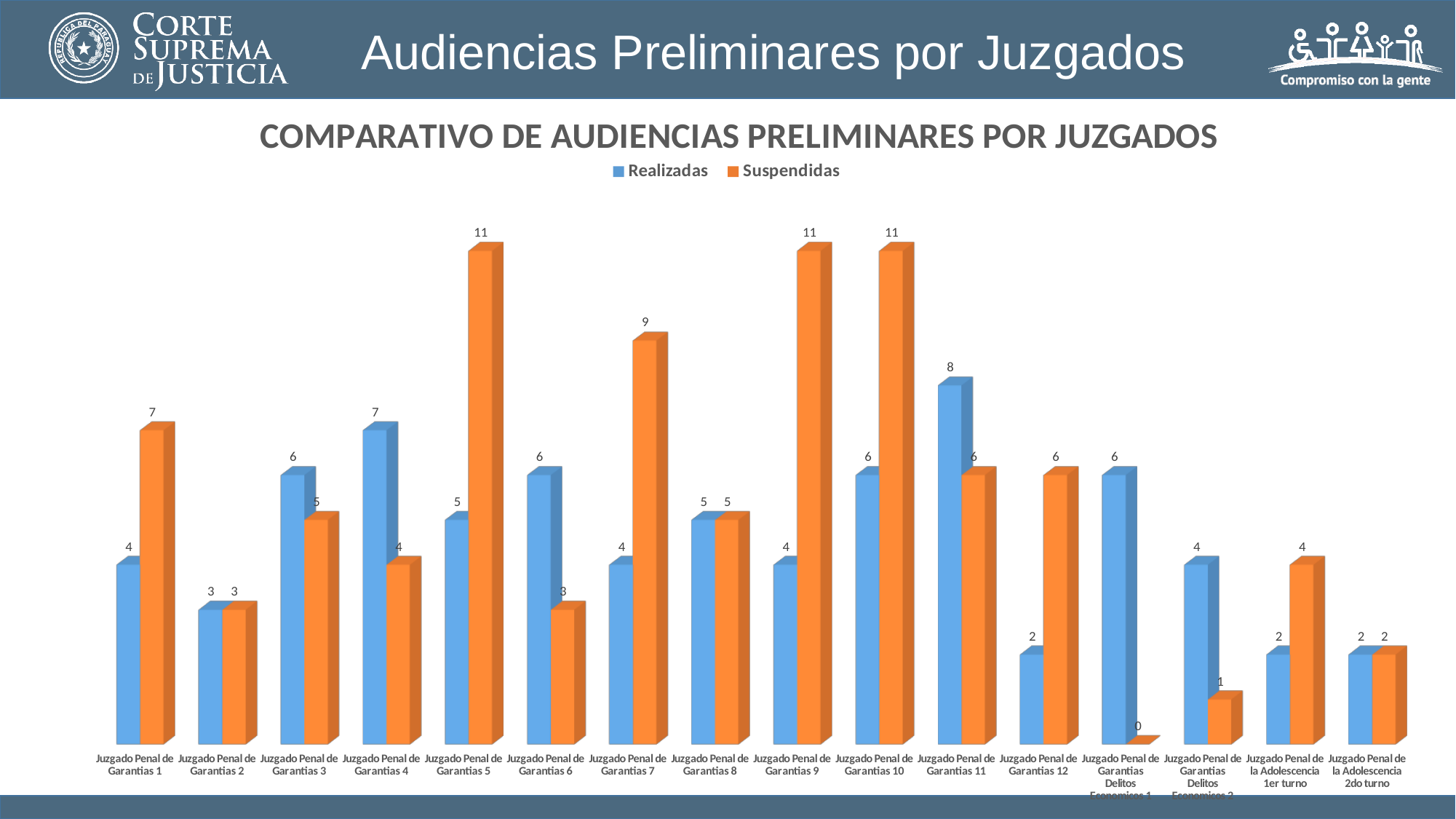
What is the Realizadas value for Juzgado Penal de la Adolescencia 1er turno? 2 What is the Suspendidas value for Juzgado Penal de Garantias 1? 7 Which juzgado has the highest Realizadas value? Juzgado Penal de Garantias 11 Which juzgado has the lowest Suspendidas value? Juzgado Penal de Garantias Delitos Economicos 1 What is the Suspendidas value for Juzgado Penal de Garantias 7? 9 What is the Realizadas value for Juzgado Penal de Garantias 11? 8 Which is larger for Juzgado Penal de Garantias 12: Realizadas or Suspendidas? Suspendidas How many series does the legend list? 2 Which is larger for Juzgado Penal de Garantias 4: Realizadas or Suspendidas? Realizadas What kind of chart is shown on the slide? Bar chart What is the difference between Suspendidas and Realizadas for Juzgado Penal de Garantias 5? 6 How many juzgados (categories) are shown on the x axis? 16